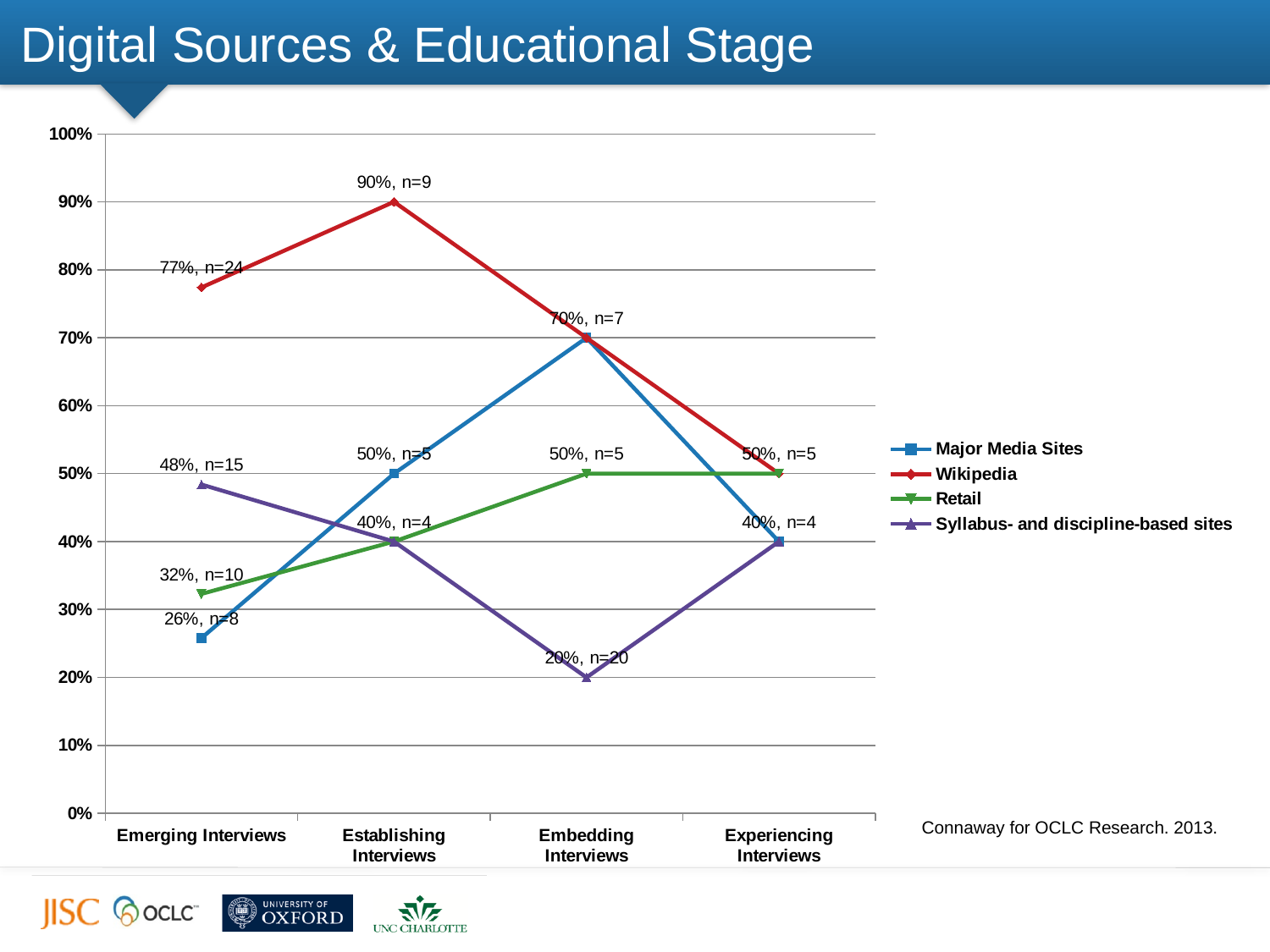
At which stage does Wikipedia reach its highest value? Establishing Interviews What kind of chart is shown on the slide? Line chart What is the value for Wikipedia at Establishing Interviews? 90% Does the Wikipedia line rise or fall from Establishing Interviews to Experiencing Interviews? Fall What is the n value shown for Wikipedia at Emerging Interviews? n=24 Which colour is used for the Wikipedia line? Red What is the value for Syllabus- and discipline-based sites at Embedding Interviews? 20% At Emerging Interviews, which is larger: Syllabus- and discipline-based sites or Retail? Syllabus- and discipline-based sites What is the difference between Wikipedia's value at Establishing Interviews and at Emerging Interviews? 13 percentage points At which stage do Syllabus- and discipline-based sites have their lowest value? Embedding Interviews How many series does the legend list? 4 How many educational stages (categories) are shown on the x axis? 4